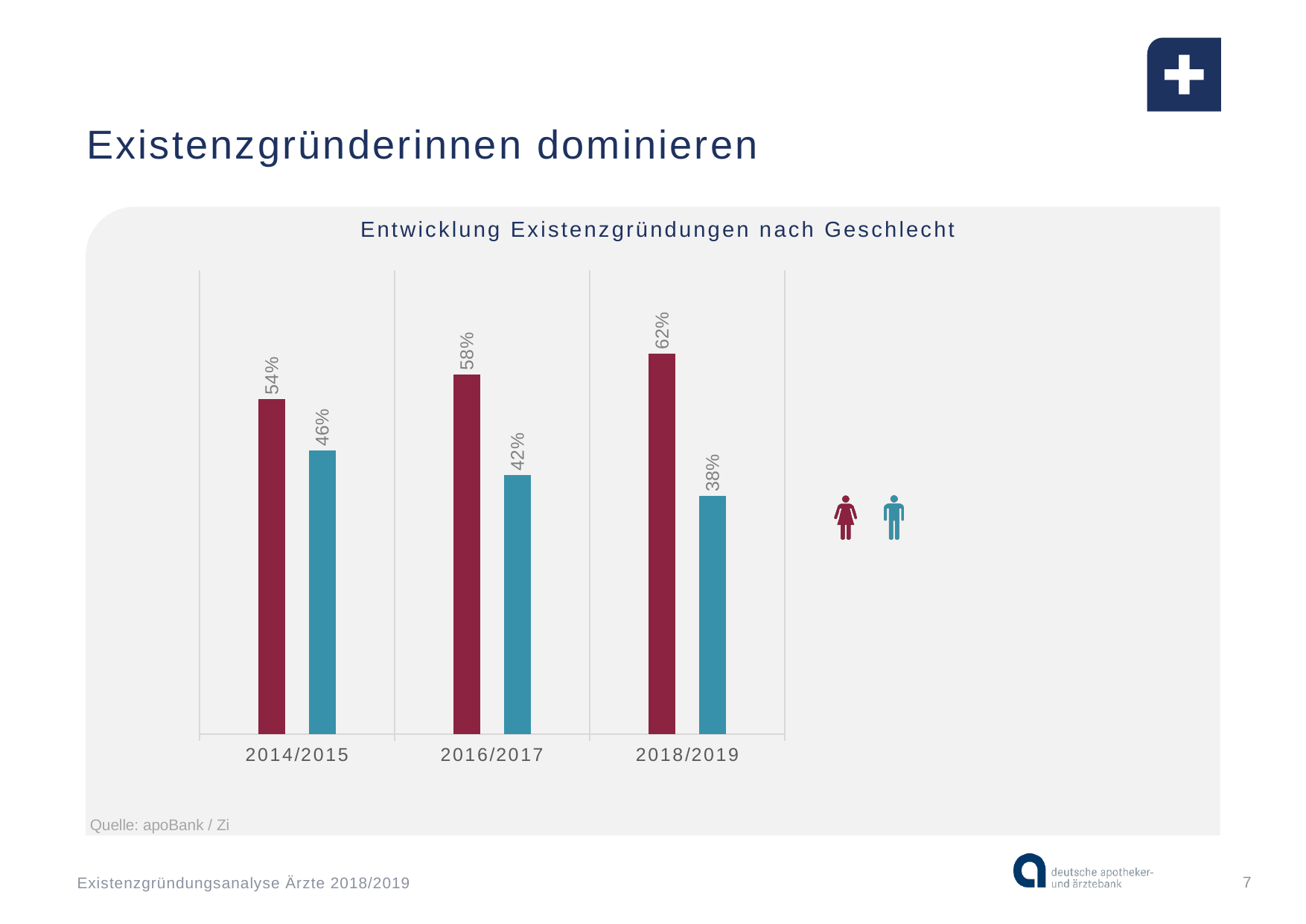
Which is larger in 2014/2015, the red bar or the blue bar? The red bar What is the value of the red bar for 2018/2019? 62% Do the values of the blue bars rise or fall from 2014/2015 to 2018/2019? Fall What is the difference between the red and blue bars in 2016/2017? 16 percentage points What is the value of the blue bar for 2018/2019? 38% How many periods are shown on the x axis? 3 In which period is the blue bar lowest? 2018/2019 In which period is the red bar highest? 2018/2019 What kind of chart is shown on the slide? Bar chart What is the value of the blue bar for 2014/2015? 46% What is the value of the red bar for 2016/2017? 58% How many series does the chart show? 2